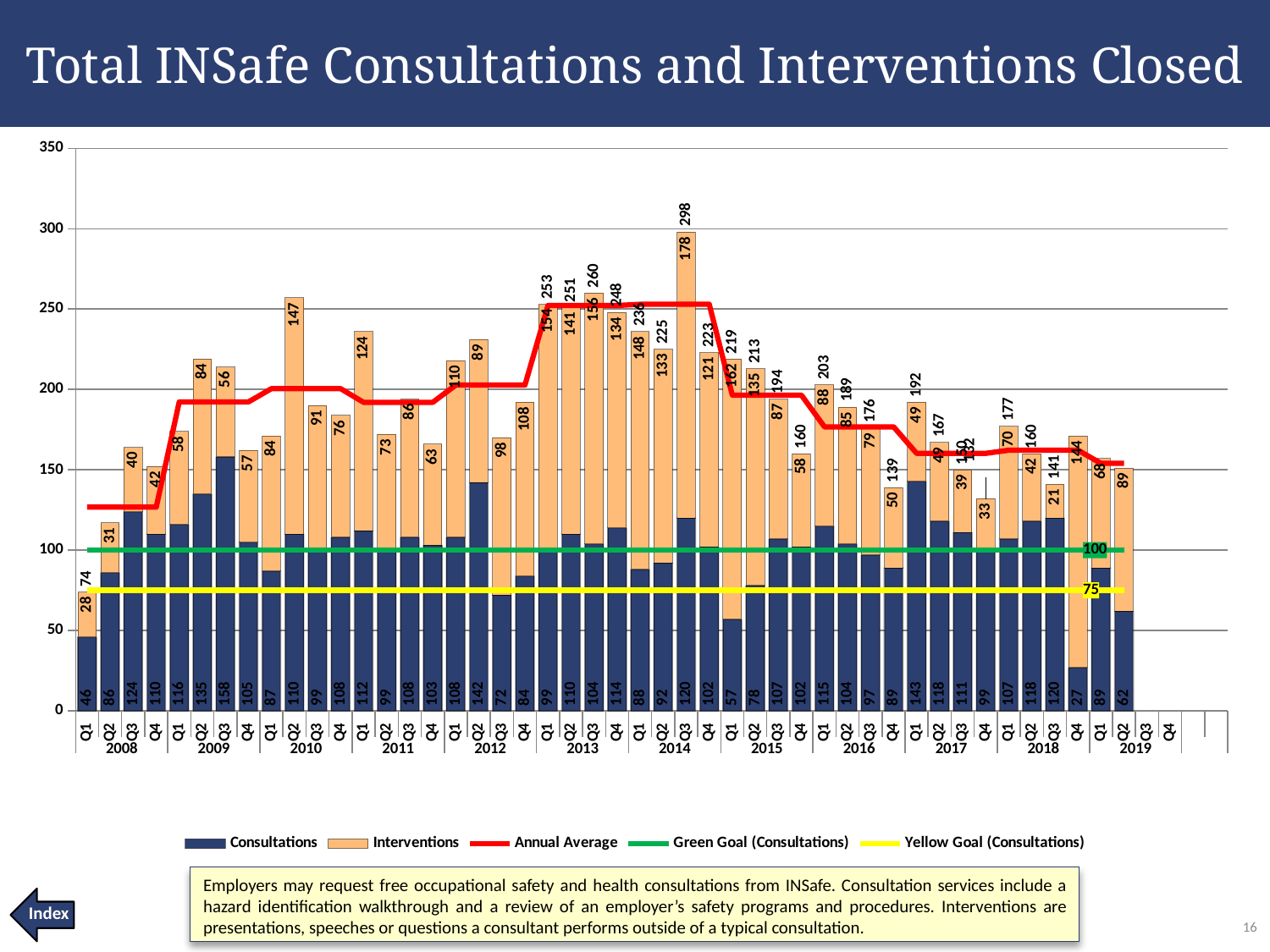
Which is larger, the Interventions value for Q2 2010 or for Q1 2011? Q2 2010 What kind of chart is shown on the slide? Stacked bar chart with line overlays What is the total of the stacked bar for Q3 2014? 298 Which quarter has the highest Consultations value? Q3 2009 Is the total for Q1 2008 greater or less than 100? less What is the Interventions value for Q3 2014? 178 What is the difference between the Consultations values for Q1 2017 and Q4 2018? 116 How many entries does the legend list? 5 Which quarter has the lowest Interventions value? Q3 2018 What is the Consultations value for Q3 2009? 158 At what value is the Green Goal (Consultations) line drawn? 100 Which quarter has the lowest Consultations value? Q4 2018